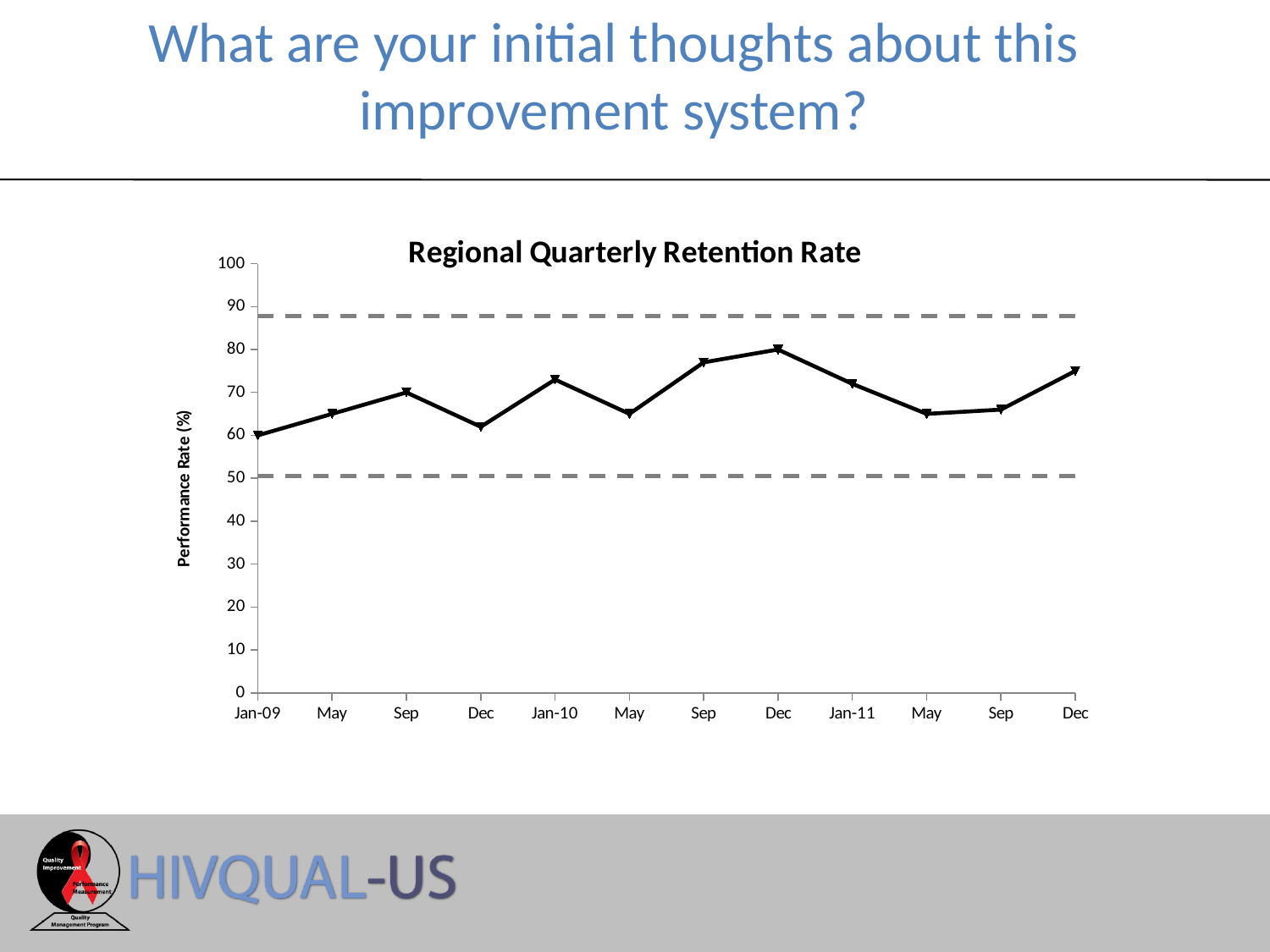
Which point on the x axis has the lowest performance rate? Jan-09 What is the performance rate for Jan-09? 60 Which point on the x axis has the highest performance rate? Dec (2010) What is the title of the chart? Regional Quarterly Retention Rate What is the label on the vertical axis of the chart? Performance Rate (%) Which is larger, the value for Jan-10 or the value for May 2010 (the May point after Jan-10)? Jan-10 What is the performance rate for Dec 2010 (the Dec point before Jan-11)? 80 How many data points are plotted on the line? 12 Is the value for Dec 2009 (the Dec point before Jan-10) greater or less than 70? less Is the value for Sep 2010 (the Sep point before Jan-11) greater or less than 70? greater Overall, does the performance rate rise or fall from Jan-09 to the final Dec point? rise What type of chart is shown on the slide? line chart